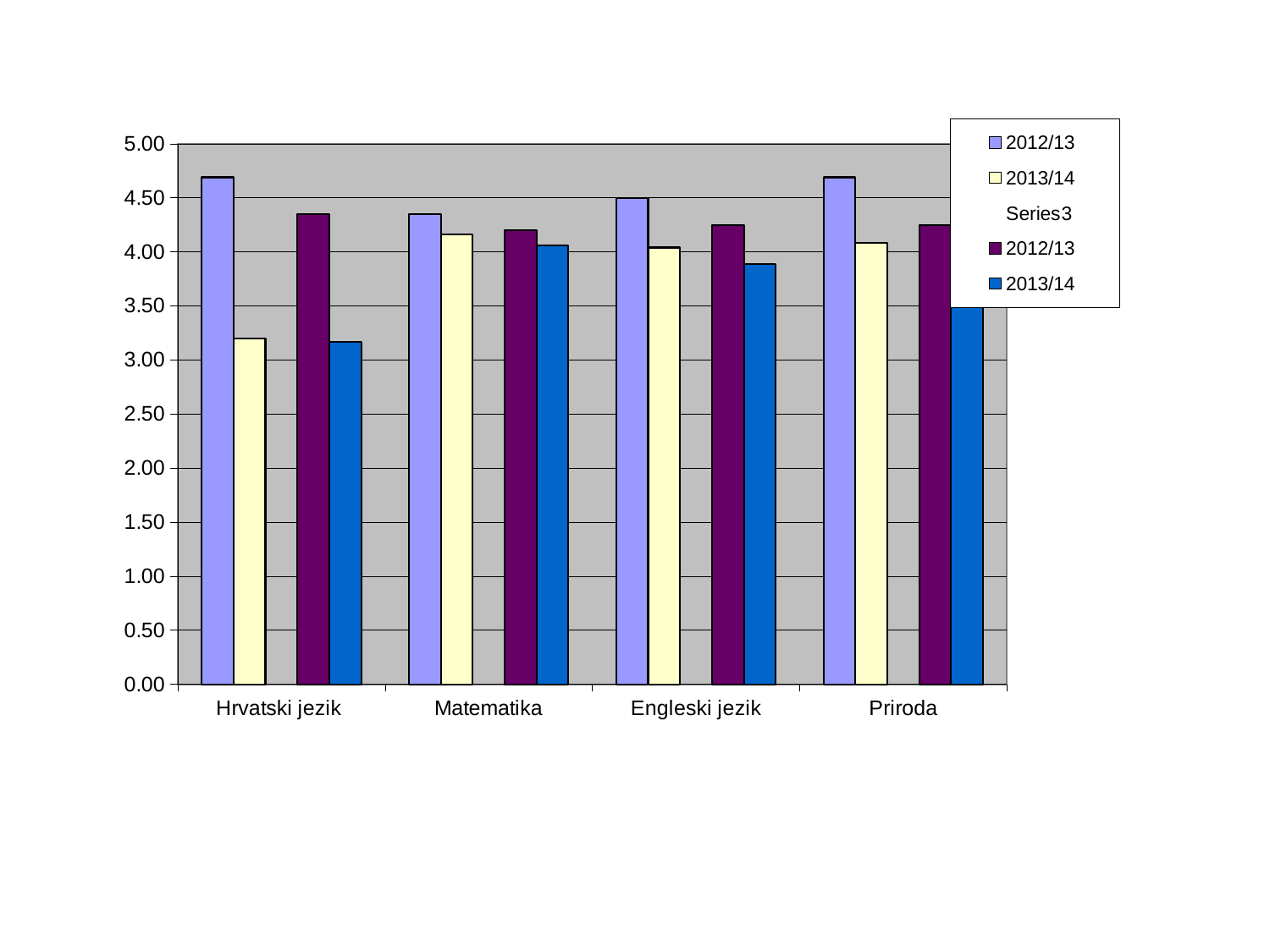
Among the yellow (first 2013/14) bars, which category has the lowest value? Hrvatski jezik For Hrvatski jezik, which is larger: the light blue bar or the yellow bar? the light blue bar Is the light blue (first 2012/13) bar for Hrvatski jezik greater or less than 4.50? greater How many categories are shown on the x axis? 4 Is the purple (second 2012/13) bar for Matematika greater or less than 4.00? greater Among the dark blue (second 2013/14) bars, which category has the lowest value? Hrvatski jezik Is the dark blue (second 2013/14) bar for Engleski jezik greater or less than 4.00? less What is the third entry listed in the legend? Series3 How many series does the legend list? 5 What kind of chart is shown on the slide? bar chart